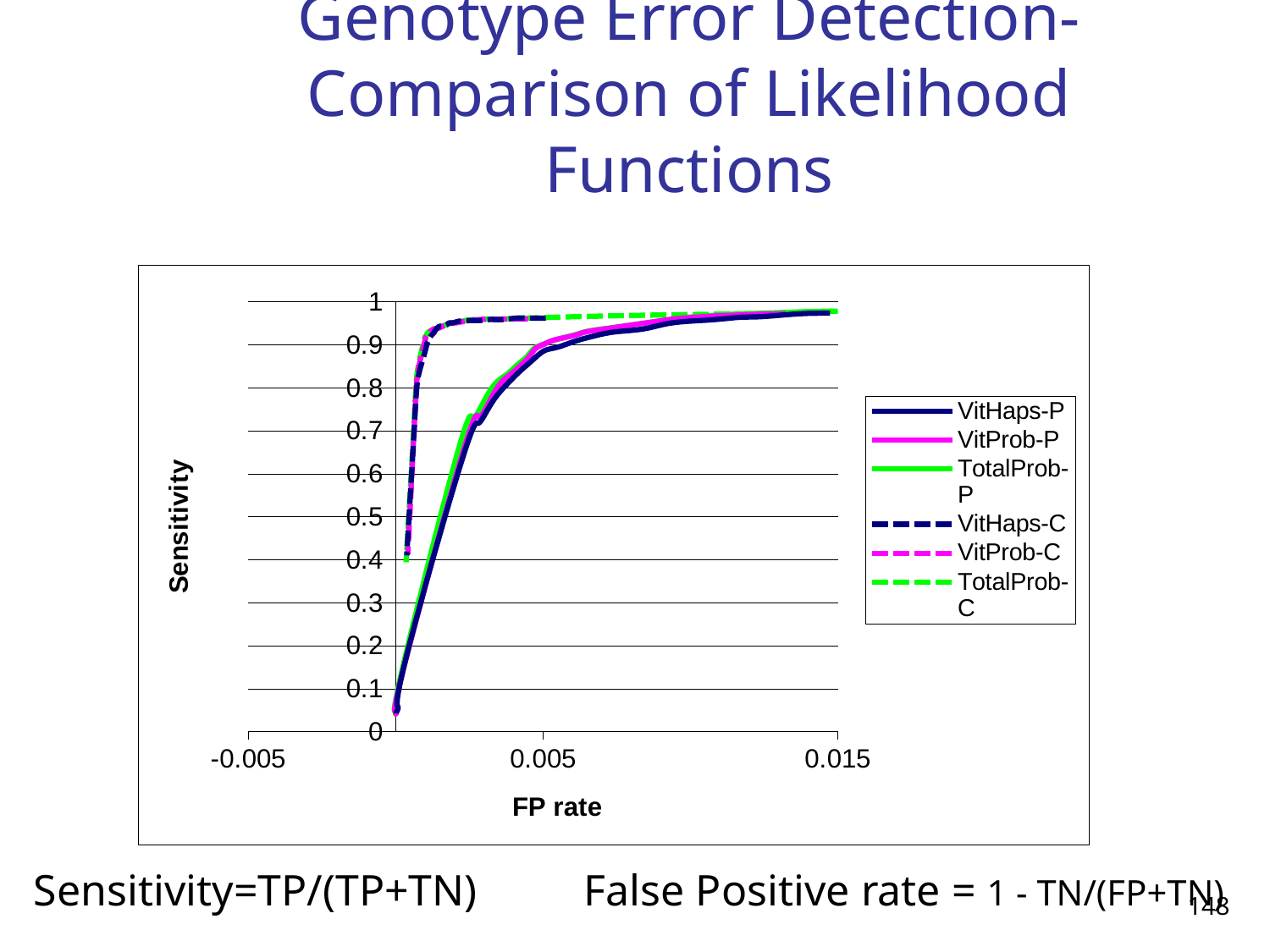
At an FP rate of 0.0025, which series has the higher sensitivity, TotalProb-C or TotalProb-P? TotalProb-C What is the label of the y axis? Sensitivity How many series does the legend list? 6 At an FP rate of 0.005, which series has the higher sensitivity, VitHaps-C or VitHaps-P? VitHaps-C At an FP rate of 0.005, is the sensitivity of VitHaps-C greater or less than 0.9? greater At an FP rate of 0.005, is the sensitivity of VitHaps-P greater or less than 0.8? greater What is the label of the x axis? FP rate Does the sensitivity of VitHaps-P rise or fall as the FP rate increases? rise What kind of chart is shown on the slide? line chart Does the sensitivity of VitProb-C rise or fall as the FP rate increases? rise At an FP rate of 0.015, is the sensitivity of TotalProb-P greater or less than 0.9? greater